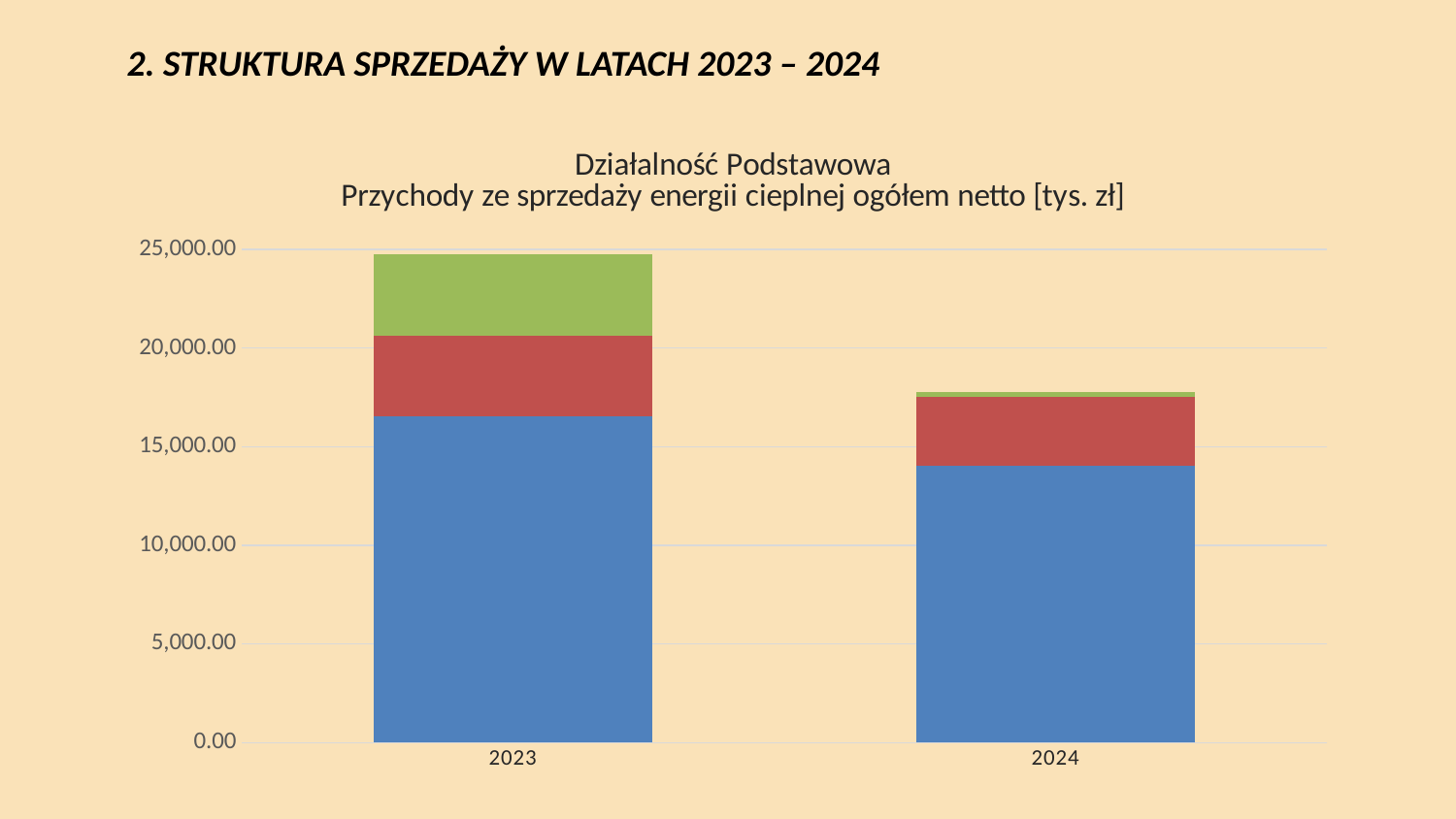
Is the total value for 2024 greater or less than 20,000.00? less How many coloured segments make up each stacked bar? 3 Which year has the higher total bar? 2023 What unit is given in the chart title for the revenues? tys. zł How many categories (years) are shown on the x axis? 2 Is the blue segment for 2024 greater or less than 15,000.00? less Which year has the lower total bar? 2024 Do the total revenues rise or fall from 2023 to 2024? fall Is the total bar for 2023 larger or smaller than the total bar for 2024? larger Is the total value for 2024 greater or less than 15,000.00? greater What kind of chart is shown on the slide? Stacked bar chart